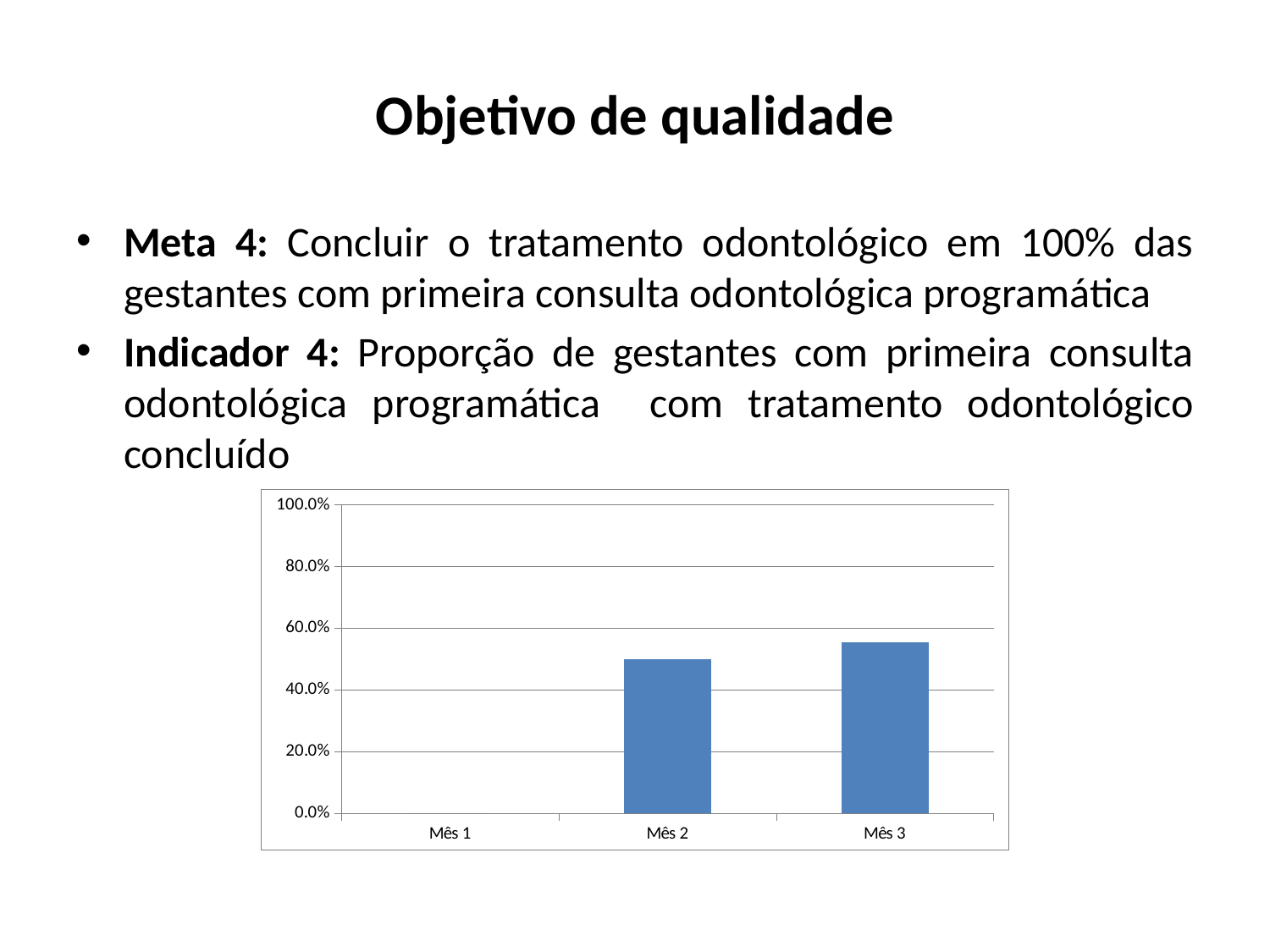
Is the value for Mês 1 greater or less than 20.0%? less Which category has the lowest value in the chart? Mês 1 What kind of chart is shown on the slide? bar chart How many categories are shown on the x axis of the chart? 3 What is the highest value shown on the y axis of the chart? 100.0% Which category has the highest value in the chart? Mês 3 Is the value for Mês 3 greater or less than 60.0%? less Is the value for Mês 3 greater or less than 40.0%? greater Which is larger, the value for Mês 2 or the value for Mês 3? Mês 3 Do the values rise or fall from Mês 1 to Mês 3? rise